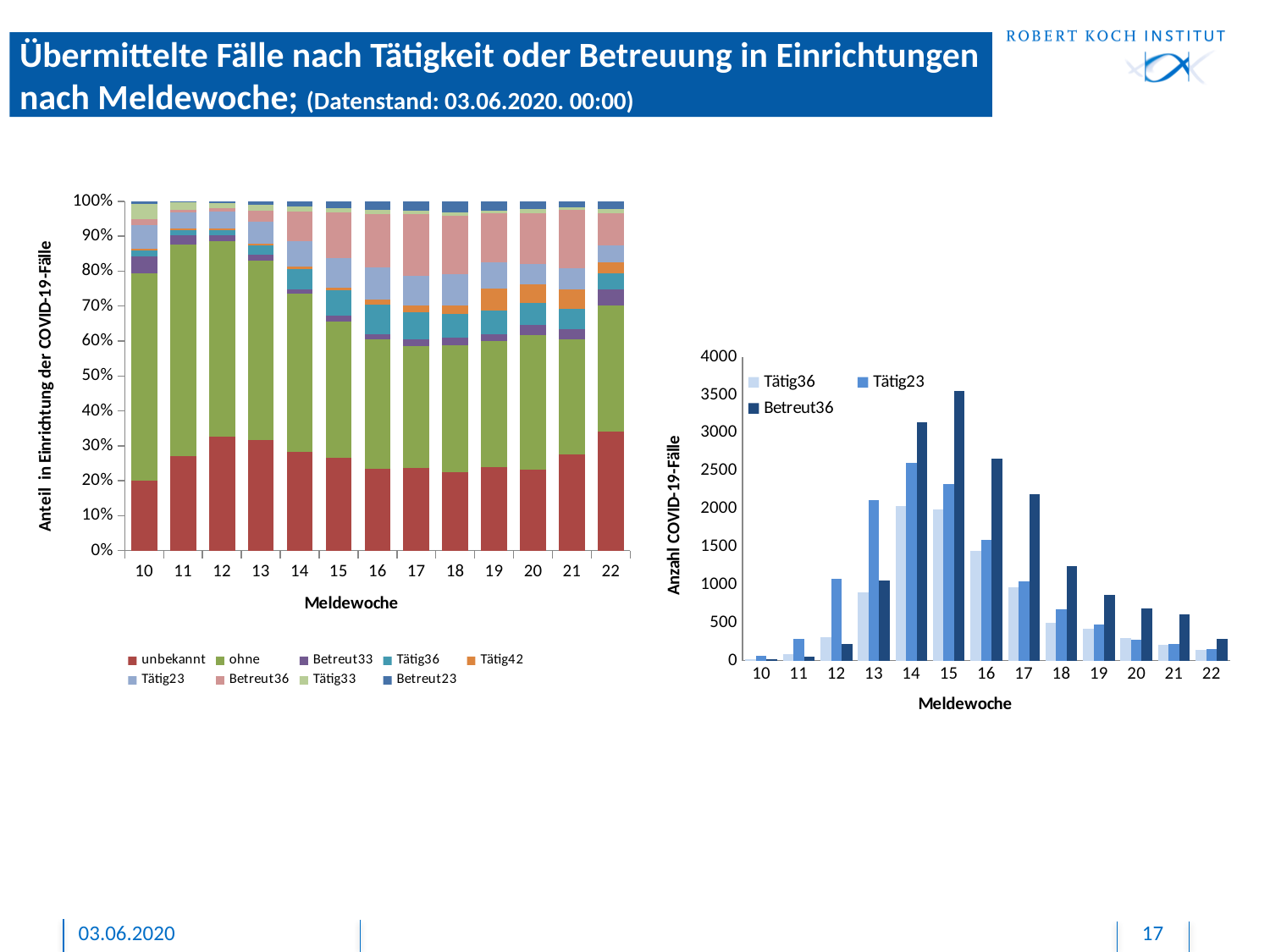
In the right chart, how many Meldewoche categories are shown on the x axis? 13 What kind of chart is the chart on the left of the slide? stacked bar chart In the right chart, in which Meldewoche is the Tätig23 value highest? 14 What kind of chart is the chart on the right of the slide? bar chart In the right chart, for Meldewoche 13, which is larger: Tätig23 or Betreut36? Tätig23 In the left chart, how many series does the legend list? 9 In the right chart, is the Betreut36 value for Meldewoche 12 greater or less than 500? less In the right chart, in which Meldewoche is the Betreut36 value highest? 15 What is the label of the y axis of the right chart? Anzahl COVID-19-Fälle In the right chart, is the Betreut36 value for Meldewoche 15 greater or less than 3000? greater In the left chart, is the share of unbekannt for Meldewoche 10 greater or less than 30%? less In the right chart, how many series does the legend list? 3